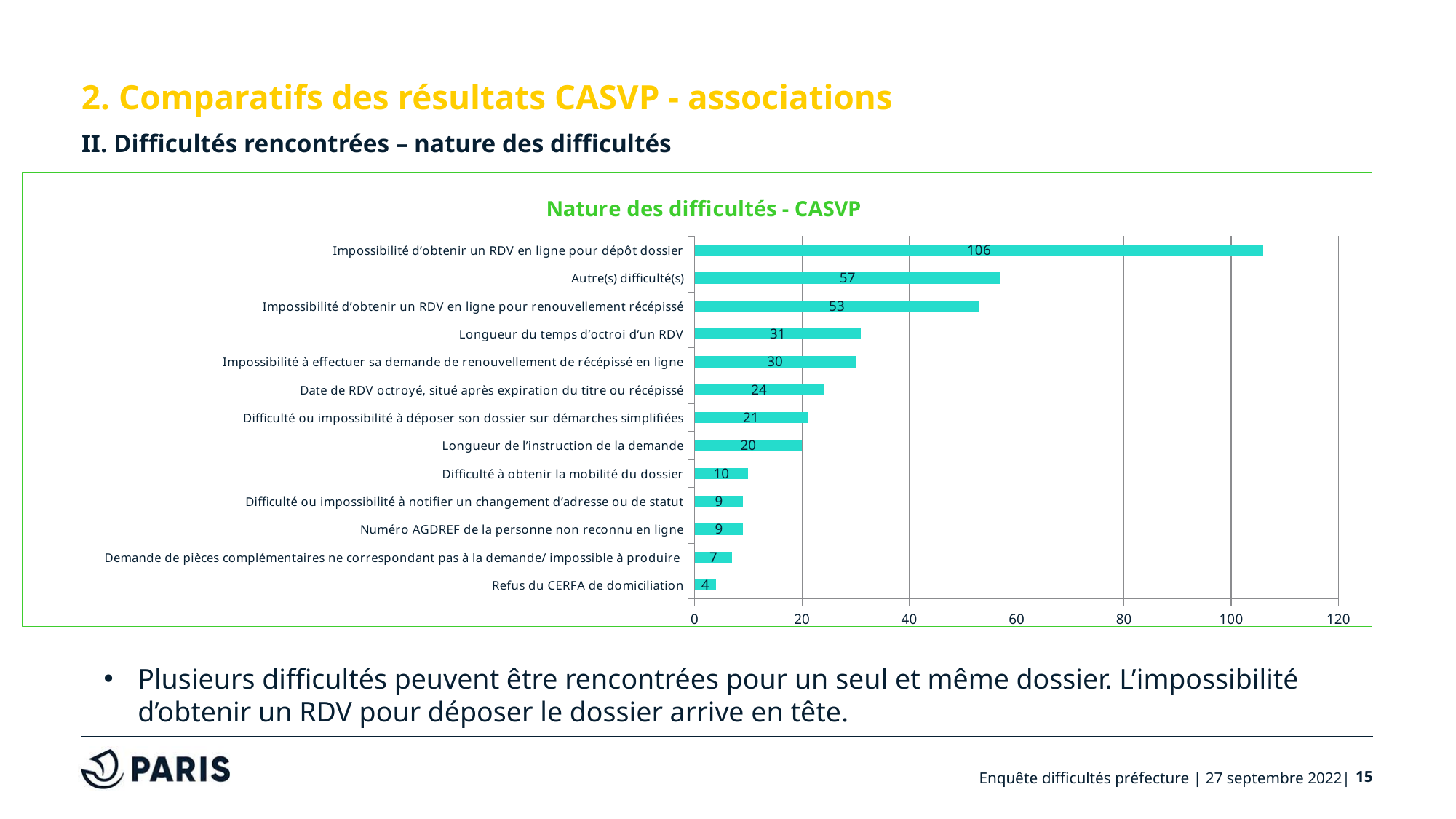
Which category has the lowest value? Refus du CERFA de domiciliation What is the value for "Longueur du temps d'octroi d'un RDV"? 31 What is the title of the chart? Nature des difficultés - CASVP What is the value for "Refus du CERFA de domiciliation"? 4 How many categories are shown in the chart? 13 What is the value for "Impossibilité d'obtenir un RDV en ligne pour dépôt dossier"? 106 Which is larger: "Date de RDV octroyé, situé après expiration du titre ou récépissé" or "Longueur de l'instruction de la demande"? Date de RDV octroyé, situé après expiration du titre ou récépissé What kind of chart is shown? Bar chart What is the difference between "Autre(s) difficulté(s)" and "Impossibilité d'obtenir un RDV en ligne pour renouvellement récépissé"? 4 Which category has the highest value? Impossibilité d'obtenir un RDV en ligne pour dépôt dossier Is the value for "Impossibilité à effectuer sa demande de renouvellement de récépissé en ligne" greater or less than 20? greater What is the difference between "Impossibilité d'obtenir un RDV en ligne pour dépôt dossier" and "Autre(s) difficulté(s)"? 49